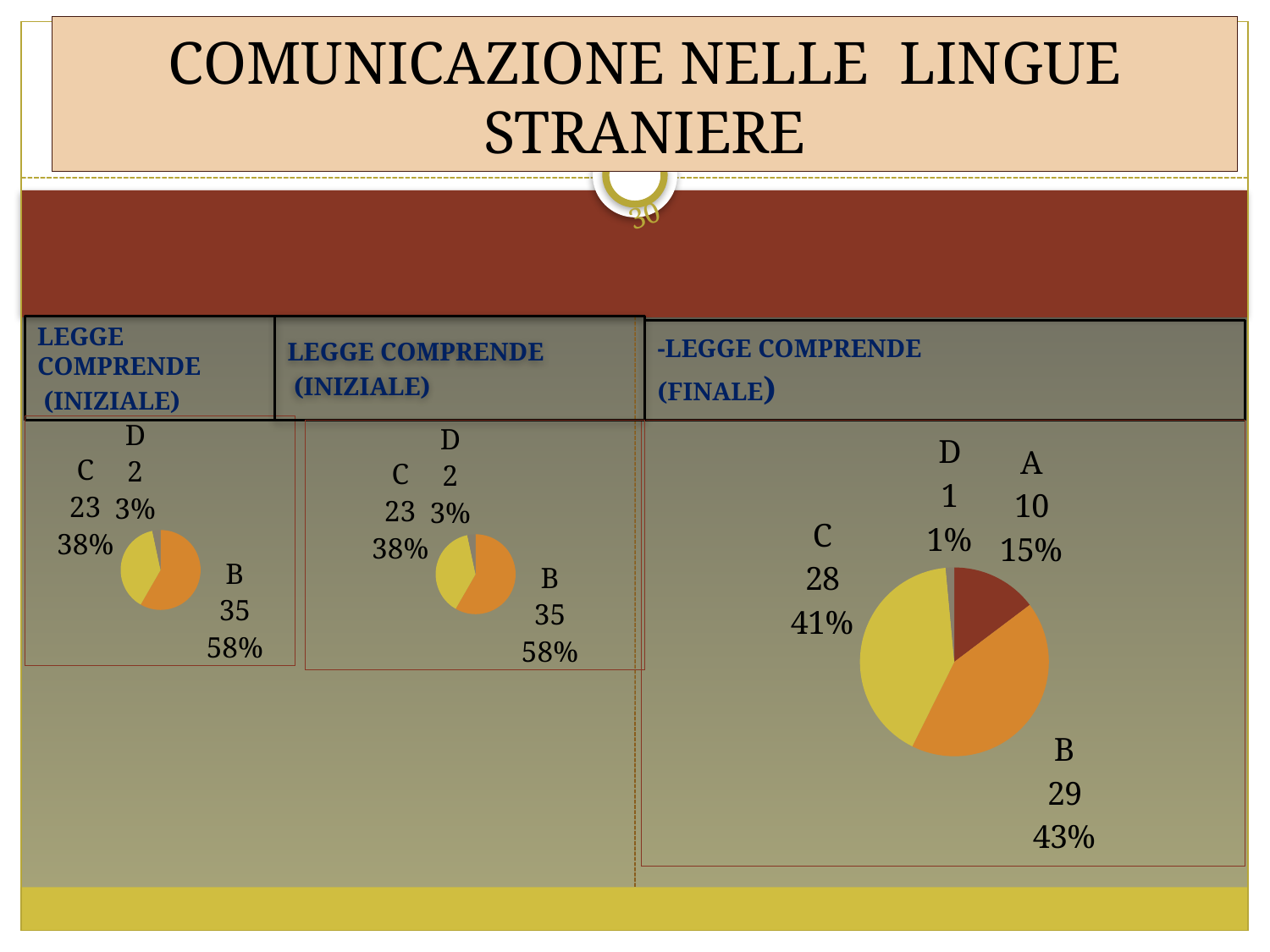
In the LEGGE COMPRENDE (FINALE) pie chart on the right, how many categories are shown? 4 In the leftmost LEGGE COMPRENDE (INIZIALE) pie chart, what is the value for category B? 35 In the LEGGE COMPRENDE (FINALE) pie chart on the right, what percentage share does category C have? 41% How many pie charts are on the slide? 3 In the LEGGE COMPRENDE (FINALE) pie chart on the right, which category has the smallest value? D In the middle LEGGE COMPRENDE (INIZIALE) pie chart, what is the difference between the values for B and C? 12 In the LEGGE COMPRENDE (FINALE) pie chart on the right, what is the value for category B? 29 In the LEGGE COMPRENDE (FINALE) pie chart on the right, what is the value for category A? 10 In the LEGGE COMPRENDE (FINALE) pie chart on the right, what is the difference between the values for A and D? 9 What type of charts are shown on the slide? pie charts In the leftmost LEGGE COMPRENDE (INIZIALE) pie chart, what percentage share does category C have? 38% In the leftmost LEGGE COMPRENDE (INIZIALE) pie chart, which category has the largest value? B